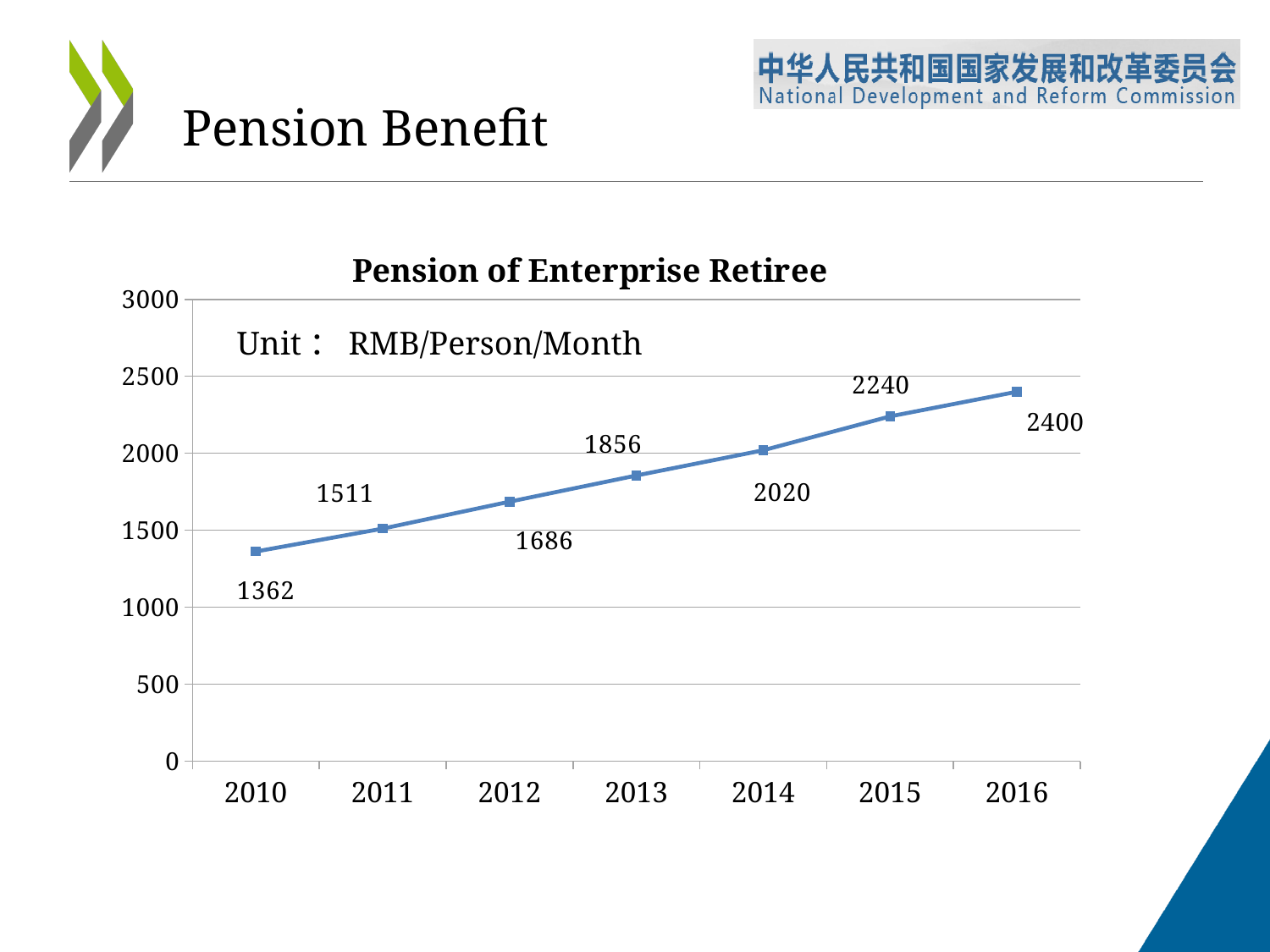
What kind of chart is shown on the slide? Line chart Which year has the lowest pension value? 2010 What is the pension of enterprise retirees in 2010? 1362 What is the pension of enterprise retirees in 2013? 1856 What unit is stated on the chart? RMB/Person/Month What is the difference between the pension in 2016 and in 2010? 1038 How many years are plotted on the chart? 7 Which year has the highest pension value? 2016 What is the pension of enterprise retirees in 2016? 2400 Do the pension values rise or fall from 2010 to 2016? Rise What is the difference between the pension in 2015 and in 2014? 220 Which year has a larger pension value, 2012 or 2014? 2014